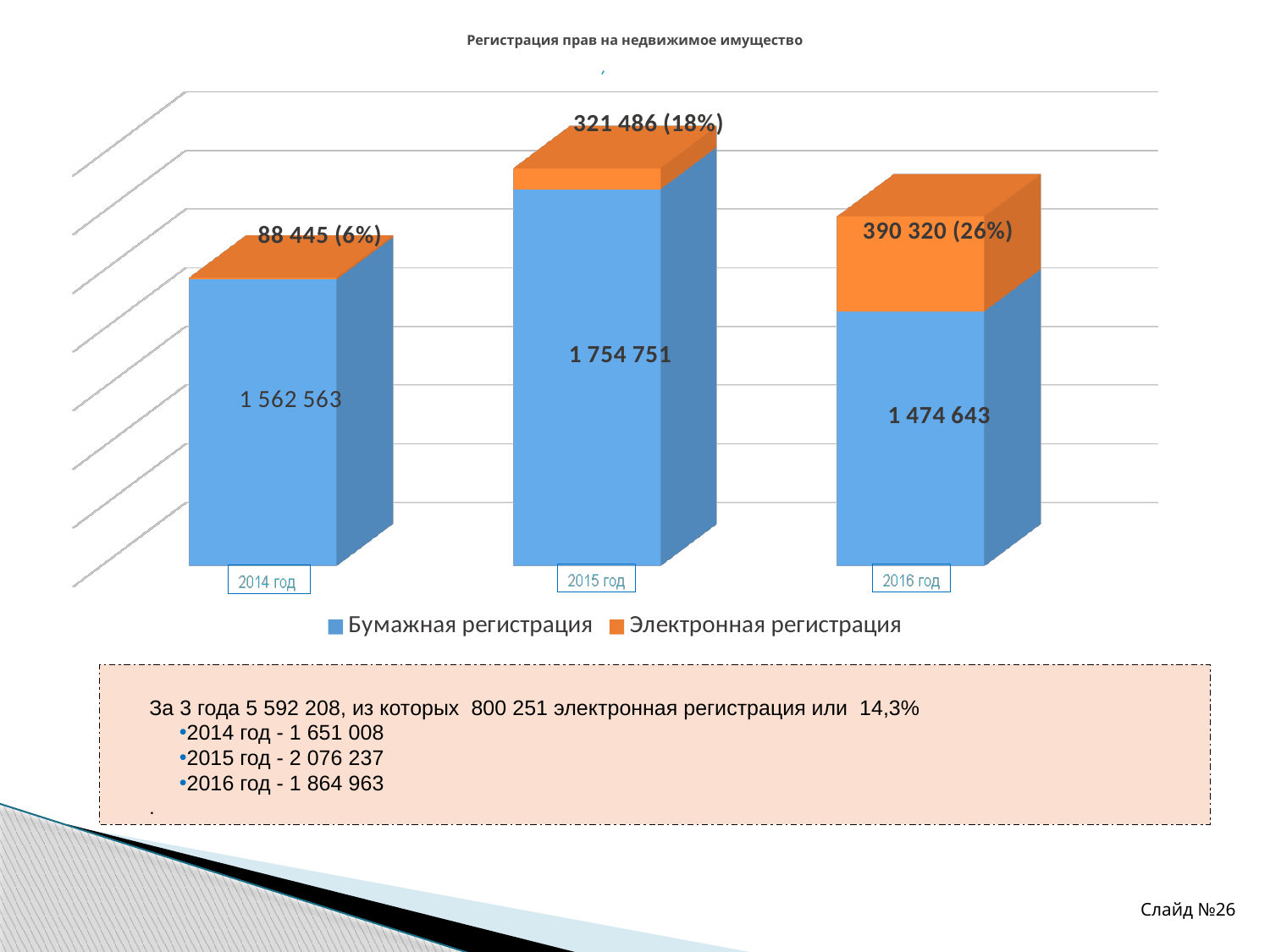
Which year has the lowest value for Электронная регистрация? 2014 год What is the value of Бумажная регистрация for 2014 год? 1 562 563 What is the total of the stacked bar for 2015 год? 2 076 237 Which colour represents Электронная регистрация in the chart? Orange What is the value of Электронная регистрация for 2016 год? 390 320 (26%) What is the difference between Электронная регистрация in 2016 год and 2015 год? 68 834 How many years are shown on the x axis? 3 How many series does the legend list? 2 What is the value of Бумажная регистрация for 2015 год? 1 754 751 Which year has the highest value for Бумажная регистрация? 2015 год What kind of chart is shown on the slide? Stacked bar chart Which is larger: Бумажная регистрация in 2014 год or in 2016 год? 2014 год